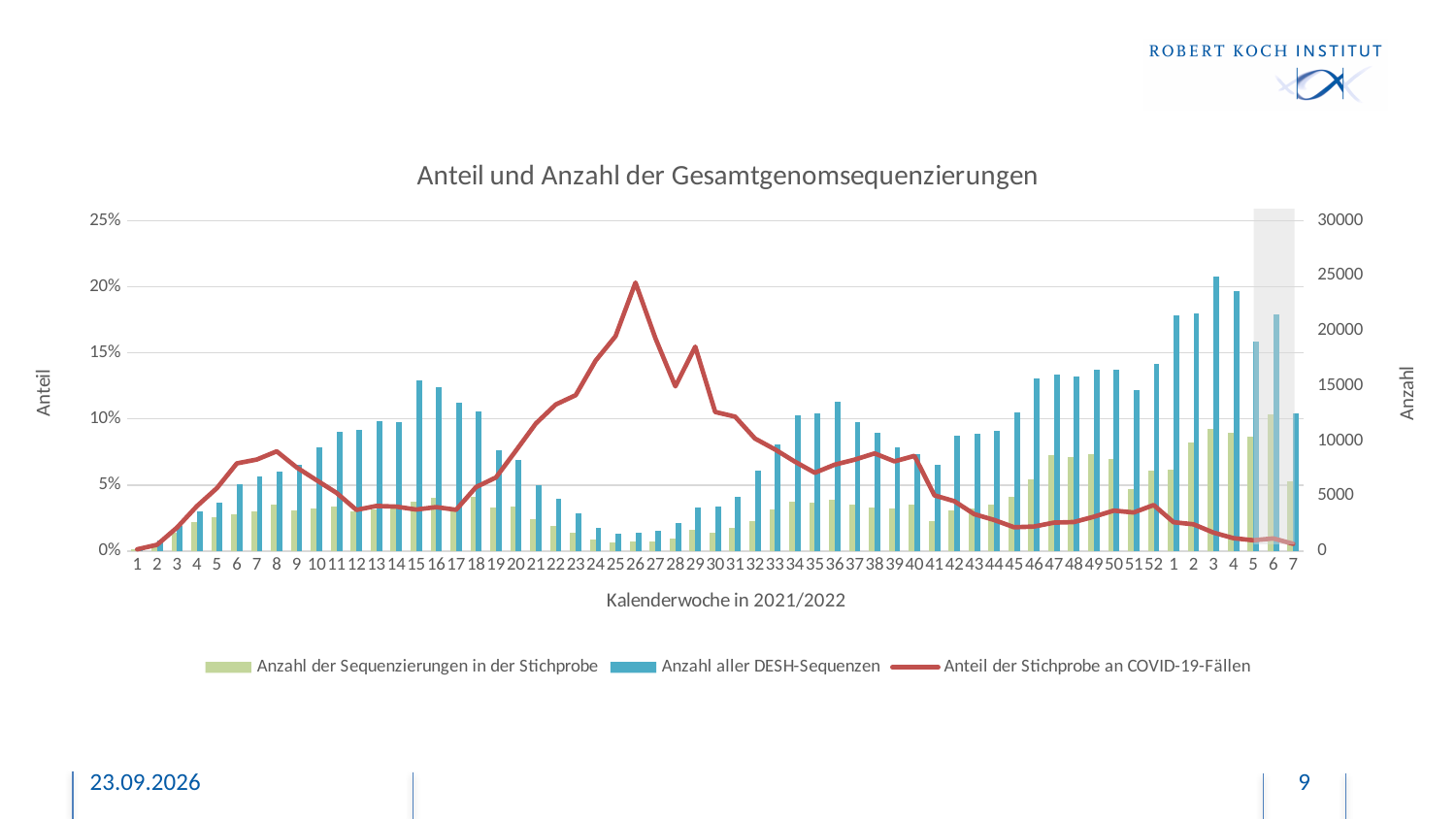
Is the value of 'Anteil der Stichprobe an COVID-19-Fällen' in calendar week 1 of 2021 greater or less than 5%? less What kind of chart is this? Combined bar and line chart Which is larger for 'Anzahl aller DESH-Sequenzen': calendar week 15 of 2021 or calendar week 26 of 2021? Calendar week 15 of 2021 Is the value of 'Anteil der Stichprobe an COVID-19-Fällen' in calendar week 26 greater or less than 15%? greater What is the label of the x axis? Kalenderwoche in 2021/2022 Is the value of 'Anzahl aller DESH-Sequenzen' in calendar week 25 of 2021 greater or less than 5000? less Does the line 'Anteil der Stichprobe an COVID-19-Fällen' rise or fall between calendar week 26 and calendar week 35 of 2021? fall How many calendar weeks are shown on the x axis? 59 What is the title of the chart? Anteil und Anzahl der Gesamtgenomsequenzierungen In which calendar week does the line 'Anteil der Stichprobe an COVID-19-Fällen' reach its highest value? 26 How many series does the chart legend list? 3